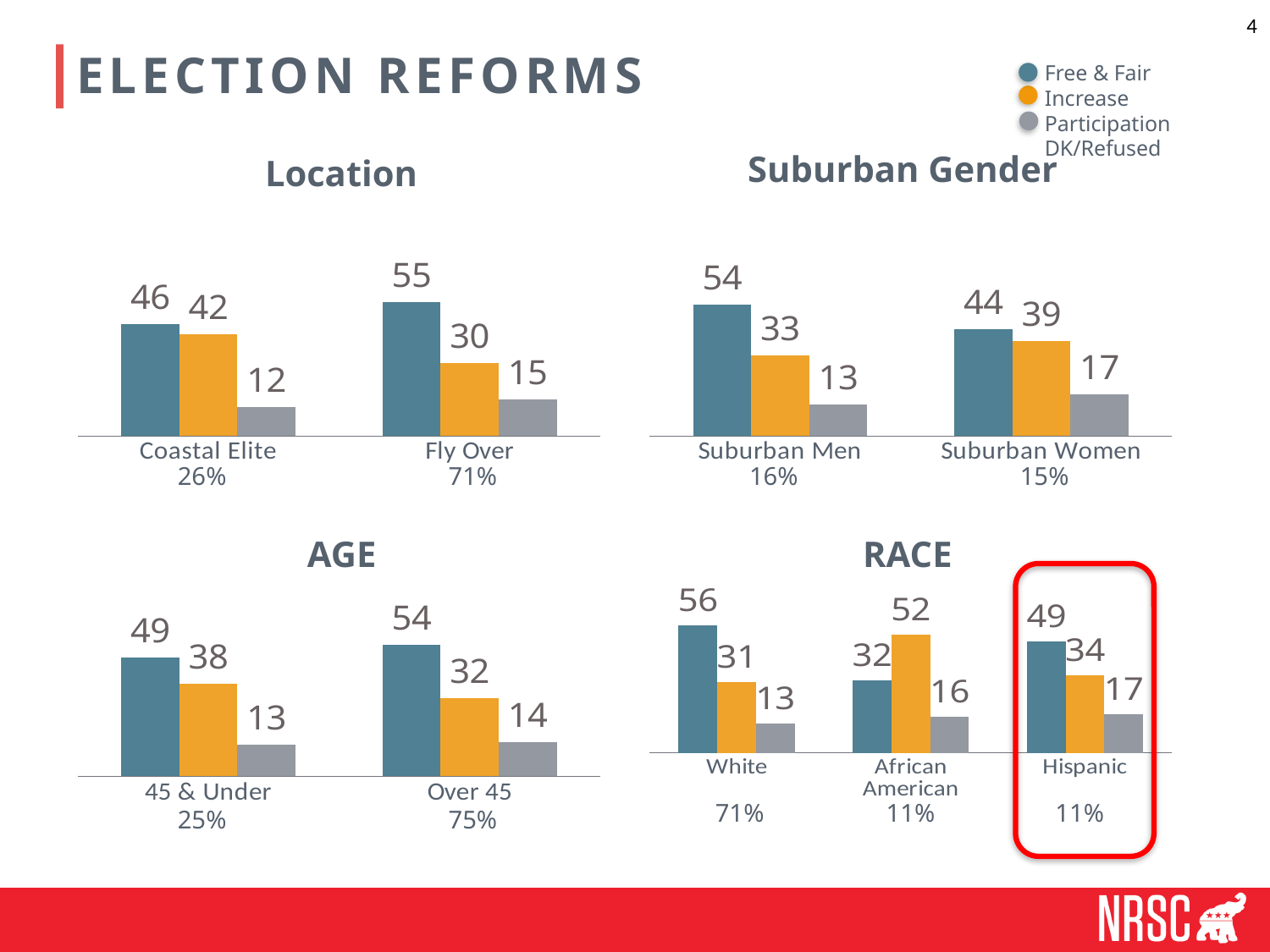
How many series does the legend list? 3 In the RACE chart, what is the difference between the Increase Participation and Free & Fair values for Hispanic? 15 How many categories are shown in the RACE chart? 3 In the Suburban Gender chart, what is the difference between the Free & Fair values for Suburban Men and Suburban Women? 10 In the Suburban Gender chart, what is the Increase Participation value for Suburban Men? 33 In the Location chart, what is the DK/Refused value for Coastal Elite? 12 In the AGE chart, which category has the higher Free & Fair value, 45 & Under or Over 45? Over 45 What type of chart is the Location chart? Bar chart In the Location chart, what is the Free & Fair value for Fly Over? 55 In the AGE chart, what is the Increase Participation value for 45 & Under? 38 In the RACE chart, which category has the highest Free & Fair value? White In the RACE chart, which category has the highest Increase Participation value? African American